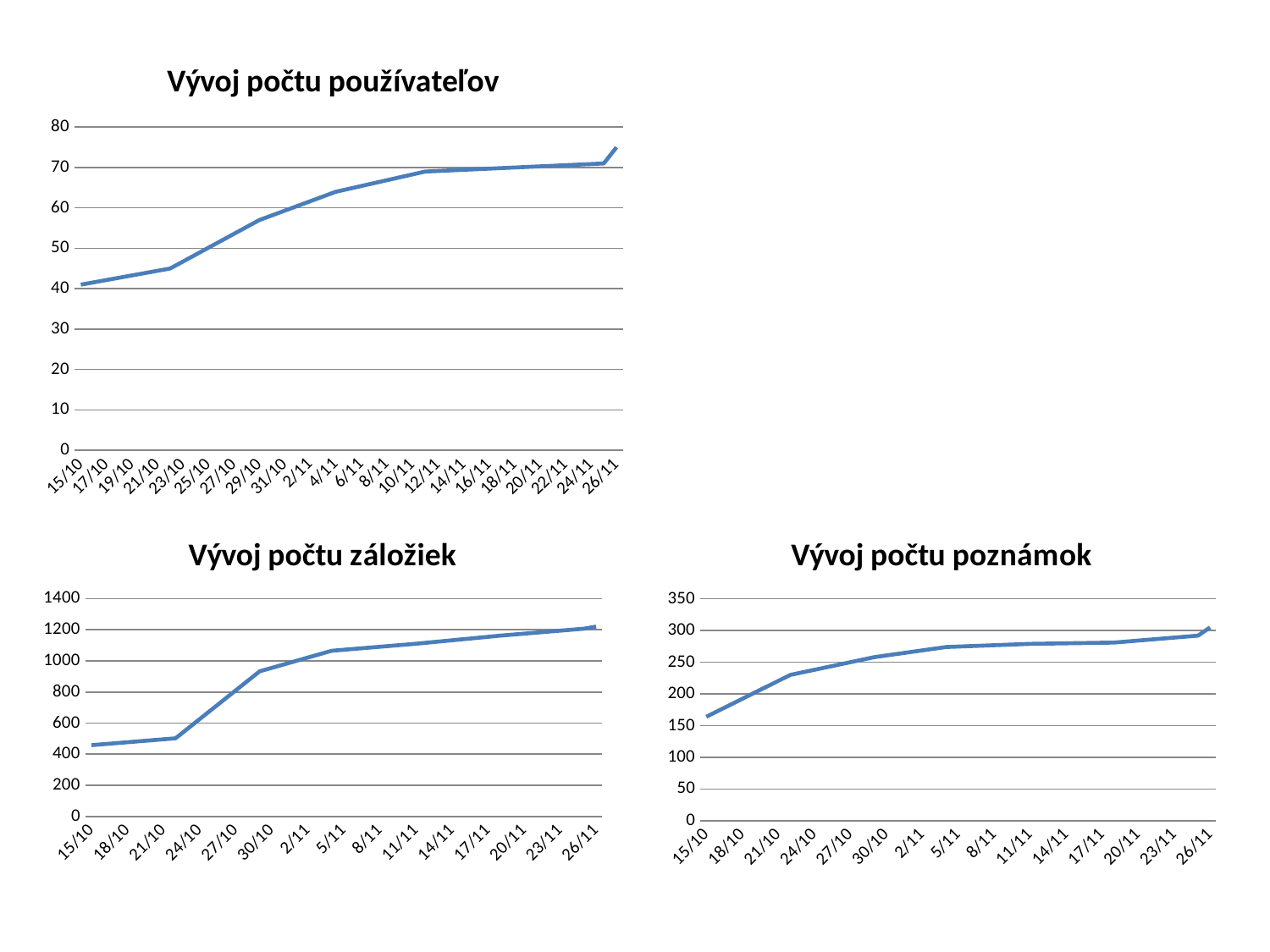
In the chart "Vývoj počtu používateľov", is the value for 26/11 greater or less than 70? greater In the chart "Vývoj počtu poznámok", is the value for 15/10 greater or less than 200? less In the chart "Vývoj počtu používateľov", which date has the highest value? 26/11 How many charts are shown on the slide? 3 In the chart "Vývoj počtu poznámok", is the value for 26/11 greater or less than 250? greater In the chart "Vývoj počtu záložiek", which date has the lowest value? 15/10 What type of chart is "Vývoj počtu používateľov"? line chart In the chart "Vývoj počtu poznámok", which is larger, the value for 15/10 or the value for 26/11? 26/11 In the chart "Vývoj počtu používateľov", do the values rise or fall from 15/10 to 26/11? rise